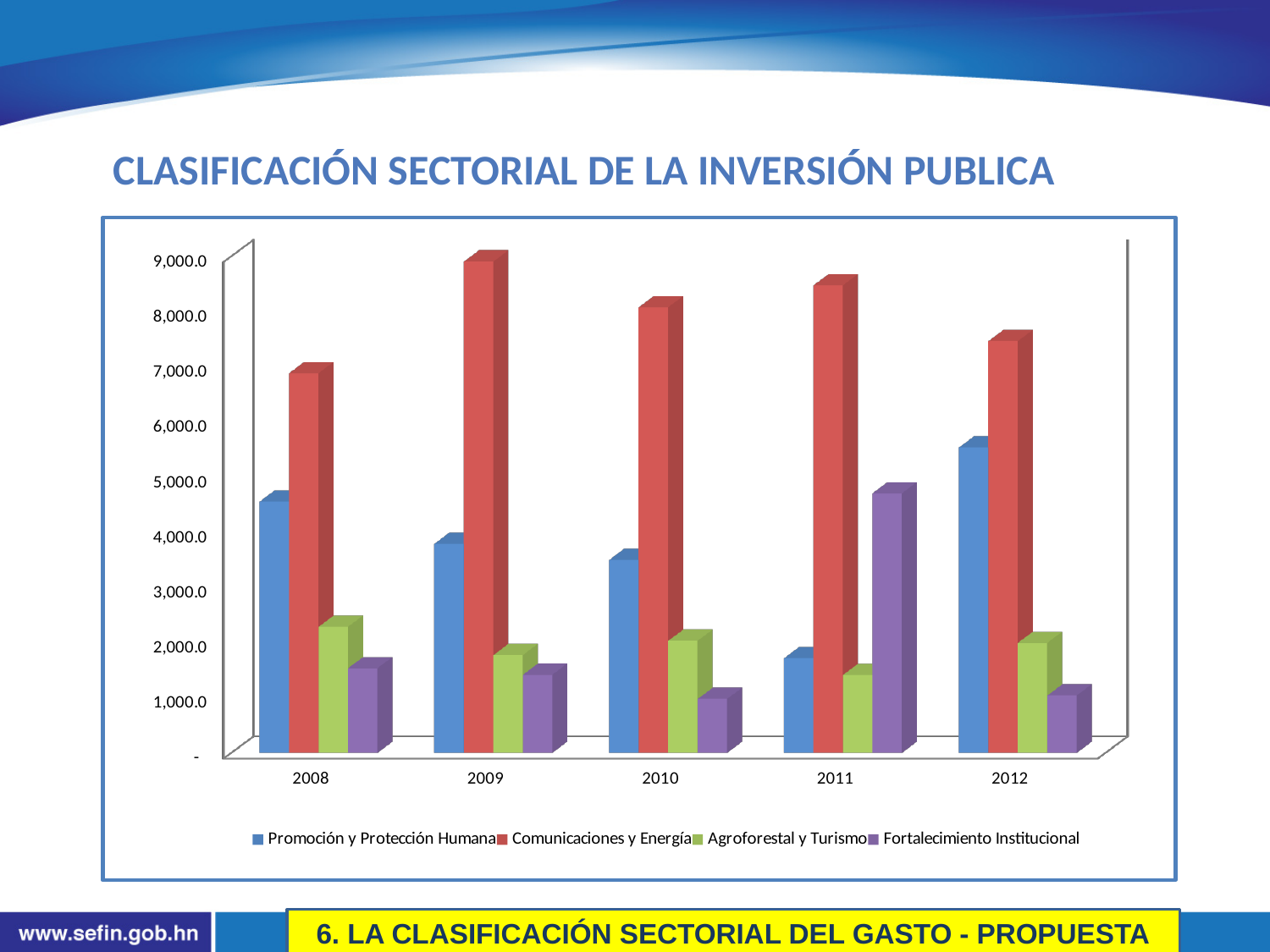
How many years are shown on the x axis? 5 Is the value for Promoción y Protección Humana in 2012 greater or less than 5,000.0? greater In which year is the value for Comunicaciones y Energía highest? 2009 What kind of chart is shown on the slide? bar chart Which is larger in 2011: Promoción y Protección Humana or Fortalecimiento Institucional? Fortalecimiento Institucional In which year is the value for Promoción y Protección Humana lowest? 2011 Does the value for Promoción y Protección Humana rise or fall from 2008 to 2011? fall In which year is the value for Fortalecimiento Institucional highest? 2011 Is the value for Agroforestal y Turismo in 2011 greater or less than 2,000.0? less What is the title of the chart? CLASIFICACIÓN SECTORIAL DE LA INVERSIÓN PUBLICA How many series does the legend list? 4 Is the value for Comunicaciones y Energía in 2009 greater or less than 8,000.0? greater